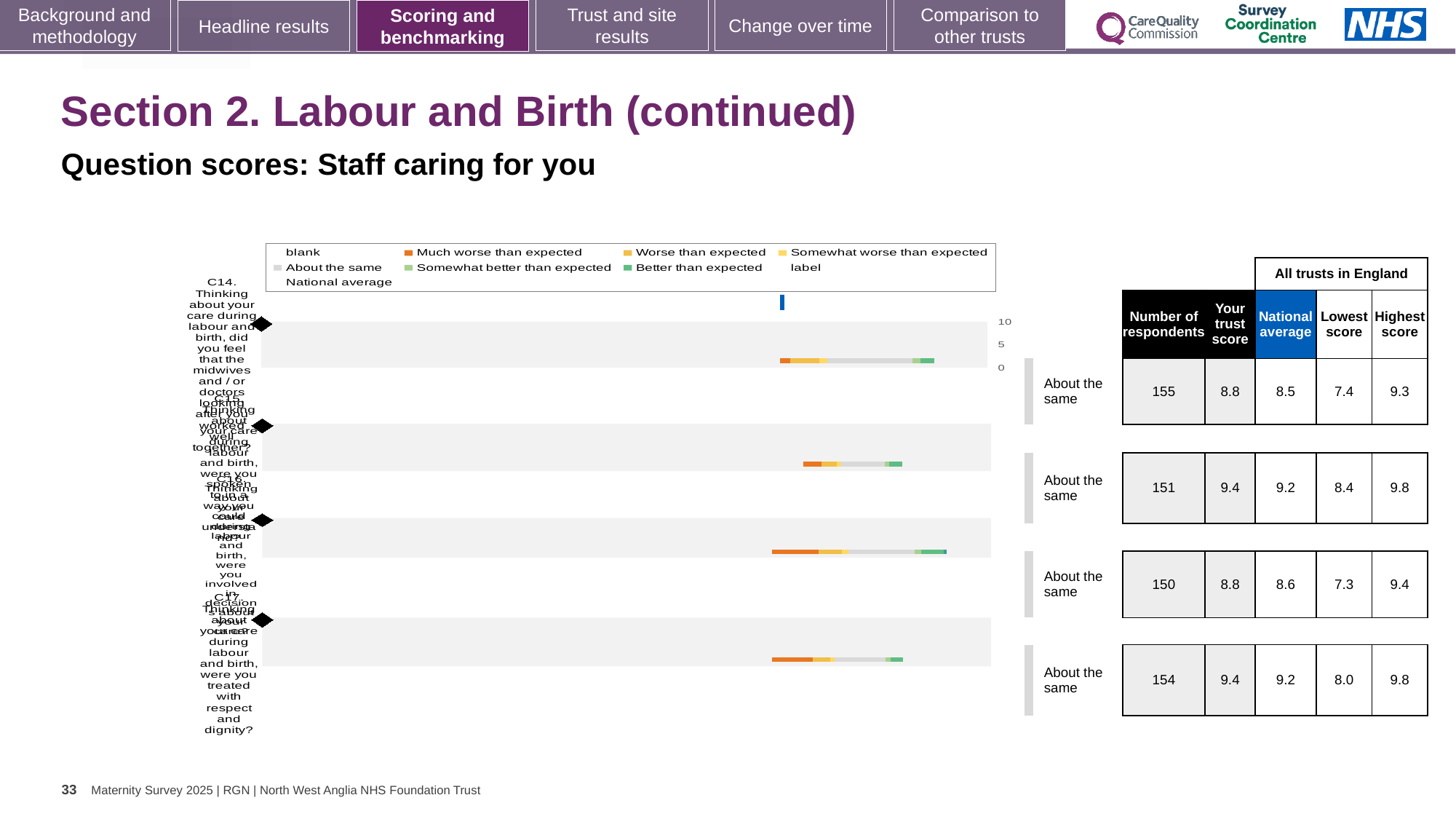
Which row of the chart has the highest number of respondents? the first (top) row, 155 What is the national average for the fourth (bottom) row of the chart? 9.2 Which row of the chart has the lowest 'Lowest score' value? the third row, 7.3 How many question rows (bars) does the chart show? 4 For the first (top) row, what is the difference between the trust score and the national average? 0.3 For the second row, which is larger: the trust score or the national average? the trust score (9.4) What is the number of respondents for the second row of the chart? 151 What is the lowest score for the third row of the chart? 7.3 What is the 'Your trust score' for the first (top) row of the chart? 8.8 What is the subtitle above the chart? Question scores: Staff caring for you What kind of chart is shown on the slide? bar chart What benchmark label is shown next to every row of the chart? About the same